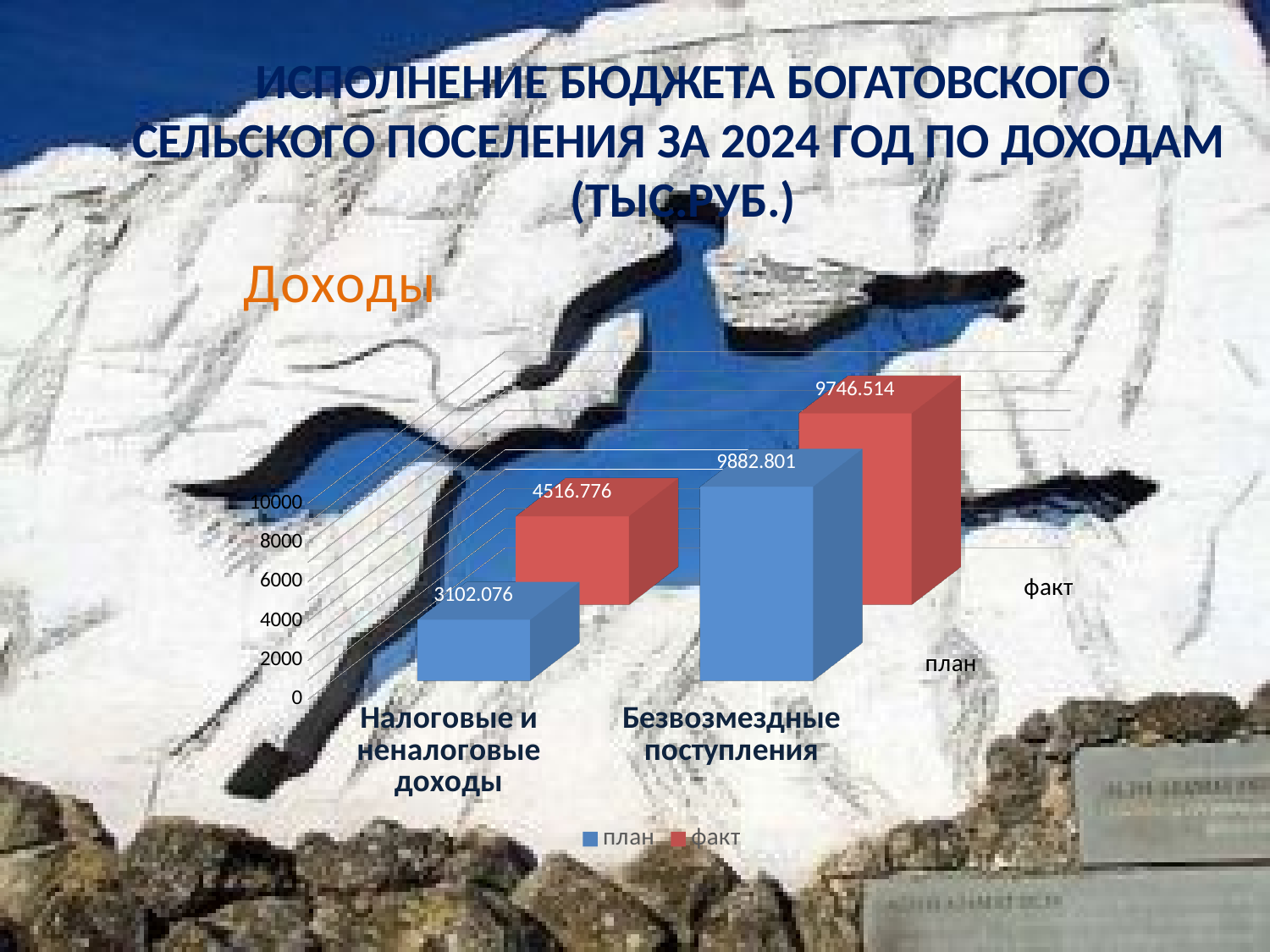
For Налоговые и неналоговые доходы, which is larger: план or факт? факт How many series does the chart legend list? 2 Which category has the lowest факт value? Налоговые и неналоговые доходы What is the difference between the факт and план values for Налоговые и неналоговые доходы? 1414.700 What kind of chart is shown on the slide? Bar chart What is the факт value for Налоговые и неналоговые доходы? 4516.776 How many categories are shown on the x axis of the chart? 2 What is the план value for Безвозмездные поступления? 9882.801 What is the план value for Налоговые и неналоговые доходы? 3102.076 What is the факт value for Безвозмездные поступления? 9746.514 What is the difference between the план and факт values for Безвозмездные поступления? 136.287 Which category has the highest план value? Безвозмездные поступления